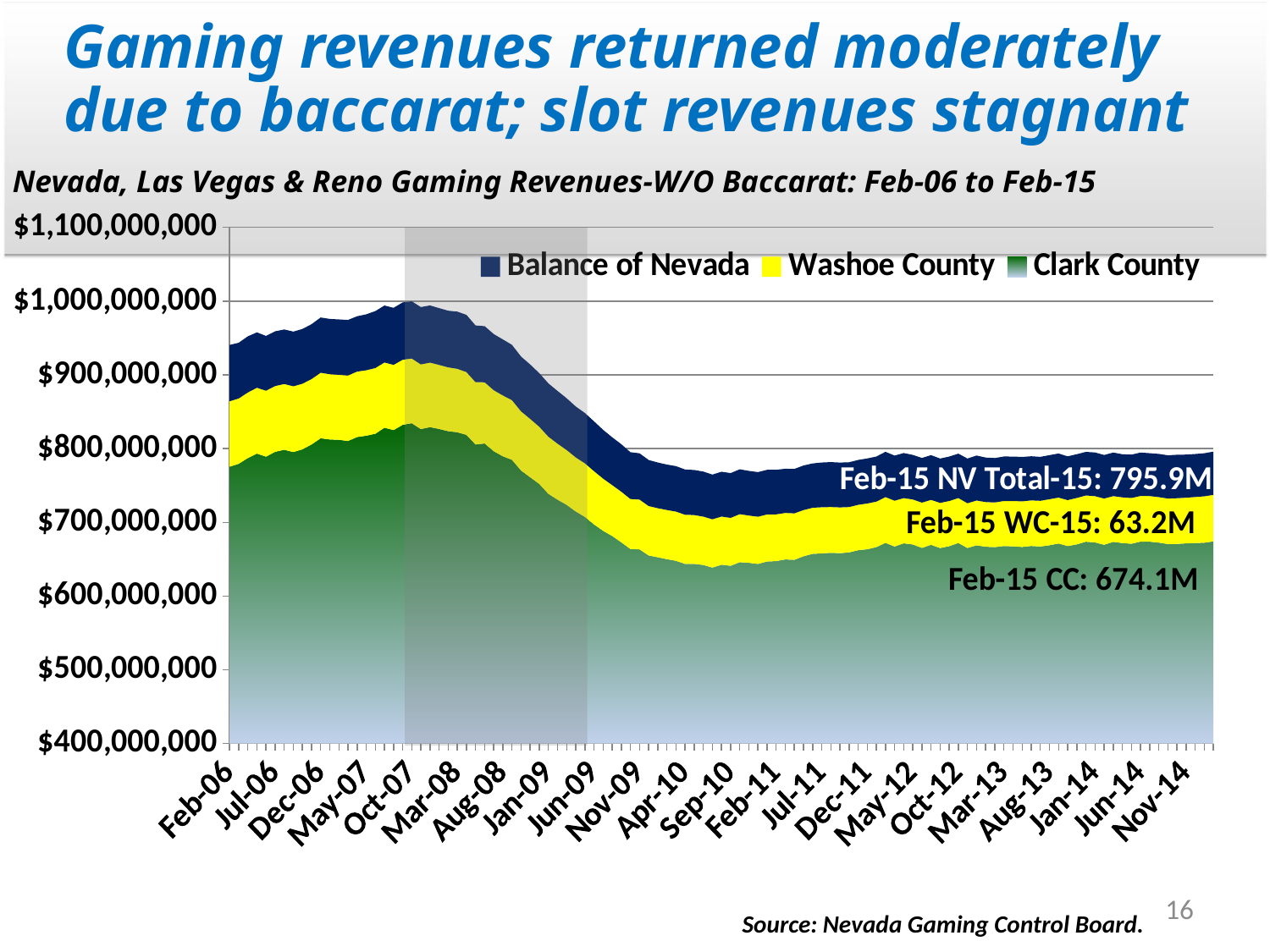
Which series is shown in yellow in the legend? Washoe County Does the total stacked revenue rise or fall between Oct-07 and Nov-09? fall Which is larger in Feb-15, the Clark County value or the Washoe County value? Clark County What is the Feb-15 value for Clark County (CC)? 674.1M Is the total stacked value around Oct-07 greater or less than $900,000,000? greater What is the Feb-15 value for Washoe County (WC)? 63.2M How many series does the legend list? 3 What kind of chart is shown on the slide? Stacked area chart By how much does the Feb-15 Clark County value exceed the Feb-15 Washoe County value? 610.9M What is the Feb-15 Nevada total gaming revenue shown on the chart? 795.9M Is the total stacked value around Sep-10 greater or less than $800,000,000? less What is the title of the chart? Nevada, Las Vegas & Reno Gaming Revenues-W/O Baccarat: Feb-06 to Feb-15